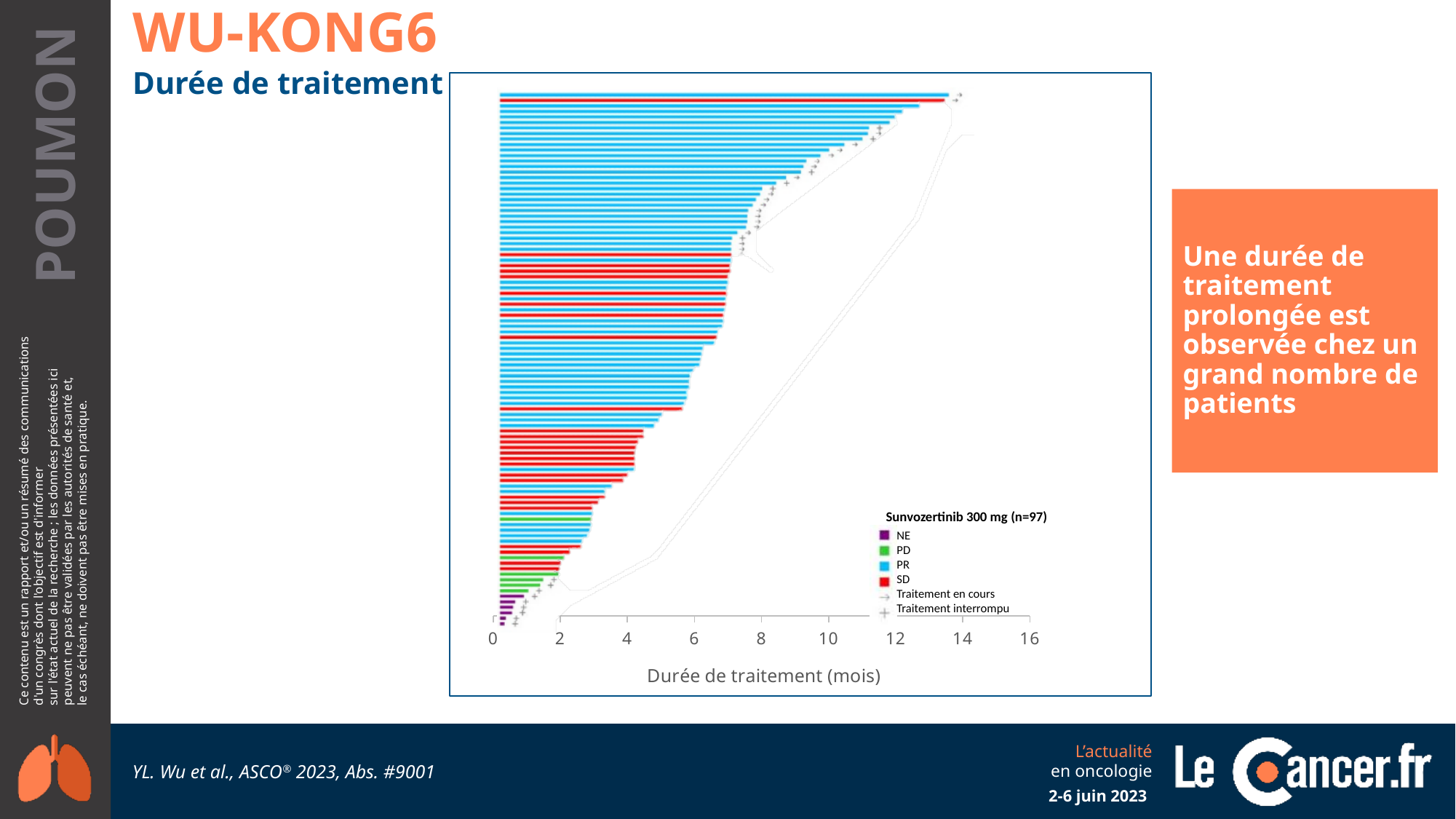
Is the duration of treatment for the longest bar greater or less than 12 months? greater How many response categories (coloured entries) does the legend list? 4 Which response category has the most bars in the chart? PR What kind of chart is shown on the slide? Bar chart Do the bar lengths increase or decrease from the top of the chart to the bottom? Decrease What is the label of the x axis of the chart? Durée de traitement (mois) What is the highest value shown on the x axis? 16 Is the duration of treatment for the longest bar greater or less than 14 months? less Is the duration of treatment for the shortest bar greater or less than 2 months? less Which colour represents PR in the chart? Blue How many patients are included in the chart, according to the legend title? 97